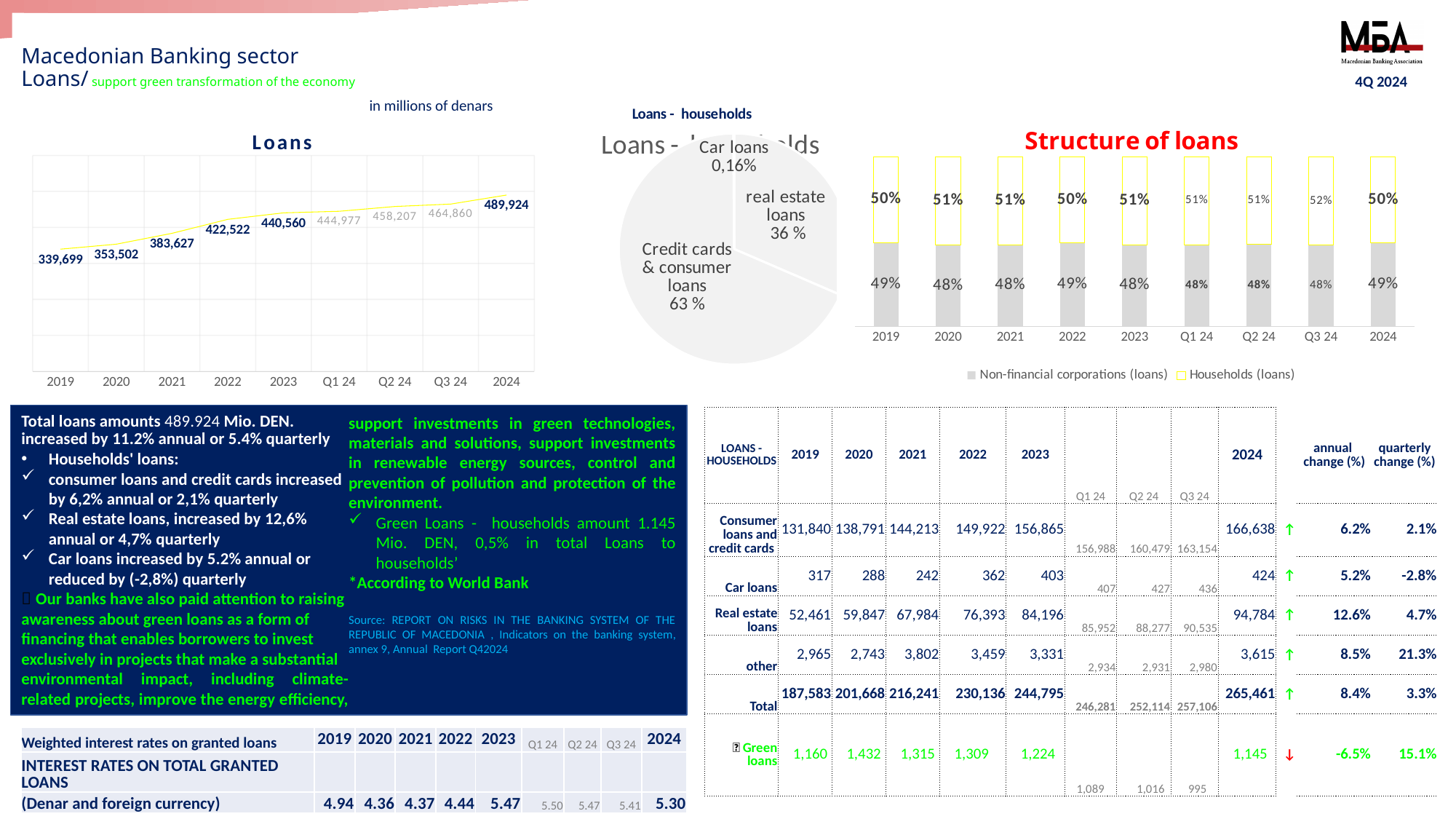
In the Loans chart, what is the value for 2024? 489,924 In the Loans chart, what is the value for Q2 24? 458,207 How many series does the legend of the Structure of loans chart list? 2 How many data points are plotted in the Loans chart? 9 In the Structure of loans chart, what is the Households (loans) share for Q3 24? 52% In the Loans - households pie chart, which category has the smallest share? Car loans In the Loans chart, do the values rise or fall from 2019 to 2024? rise What kind of chart is the Loans chart? line chart In the Loans - households pie chart, what share do Credit cards & consumer loans have? 63 % In the Loans chart, which period has the highest value? 2024 In the Loans chart, what is the value for 2019? 339,699 In the Loans chart, what is the difference between the 2024 value and the 2019 value? 150,225